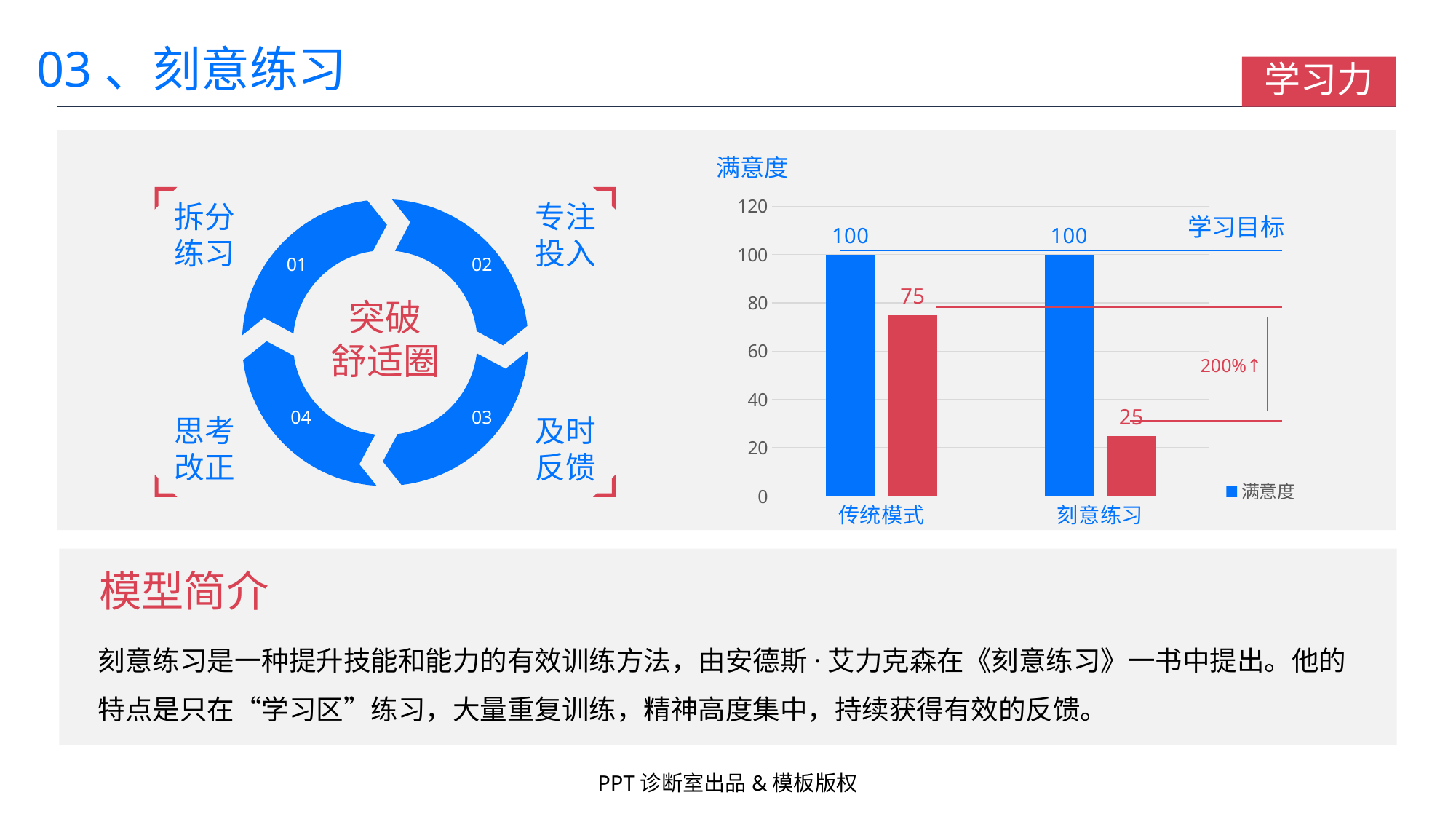
What is the title of the bar chart? 满意度 In the bar chart, what is the value of the red bar for 刻意练习? 25 In the bar chart, which category has the higher red bar, 传统模式 or 刻意练习? 传统模式 In the bar chart, what is the difference between the red bar values for 传统模式 and 刻意练习? 50 In the bar chart, what is the value of the blue bar for 刻意练习? 100 What percentage annotation is written next to the vertical arrow on the right of the bar chart? 200%↑ In the bar chart, is the red bar for 刻意练习 greater or less than 40? less How many series does the legend of the bar chart list? 1 In the bar chart, what is the value of the red bar for 传统模式? 75 What kind of chart is shown on the right side of the slide? bar chart In the bar chart, what is the value of the blue bar for 传统模式? 100 How many categories are shown on the x axis of the bar chart? 2